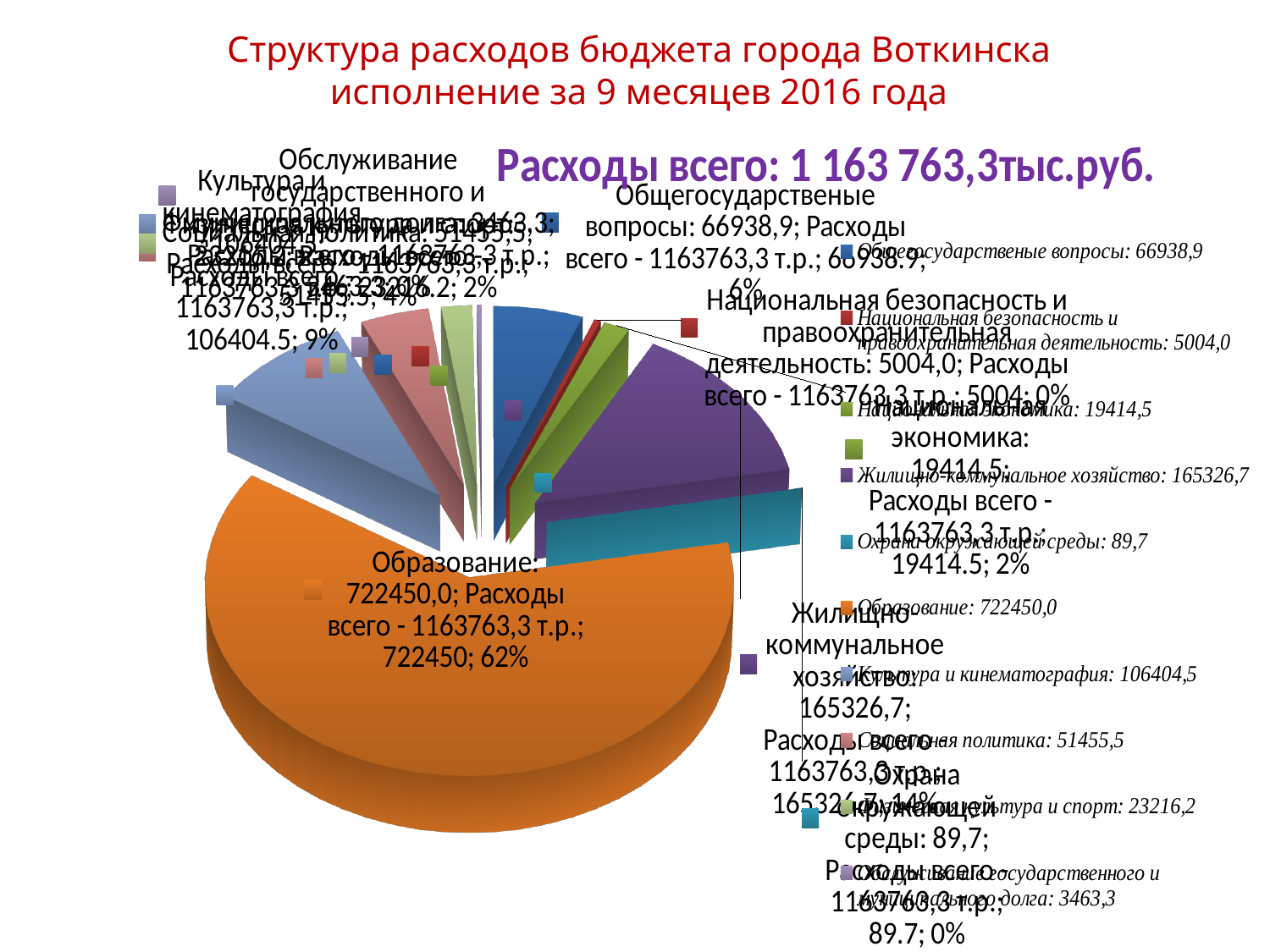
What is the value for Культура и кинематография? 106404,5 What is the value for Образование in the legend? 722450,0 Which is larger: Социальная политика or Физическая культура и спорт? Социальная политика What is the difference between the values for Образование and Жилищно-коммунальное хозяйство? 557123,3 What is the value for Жилищно-коммунальное хозяйство? 165326,7 What percentage share of the pie does Образование have? 62% What total expenditure amount is stated in the chart title? 1 163 763,3тыс.руб. Which category has the smallest value in the pie chart? Охрана окружающей среды What kind of chart is shown on the slide? pie chart How many categories does the legend of the pie chart list? 10 Which category has the largest share of the pie chart? Образование What percentage share of the pie does Жилищно-коммунальное хозяйство have? 14%